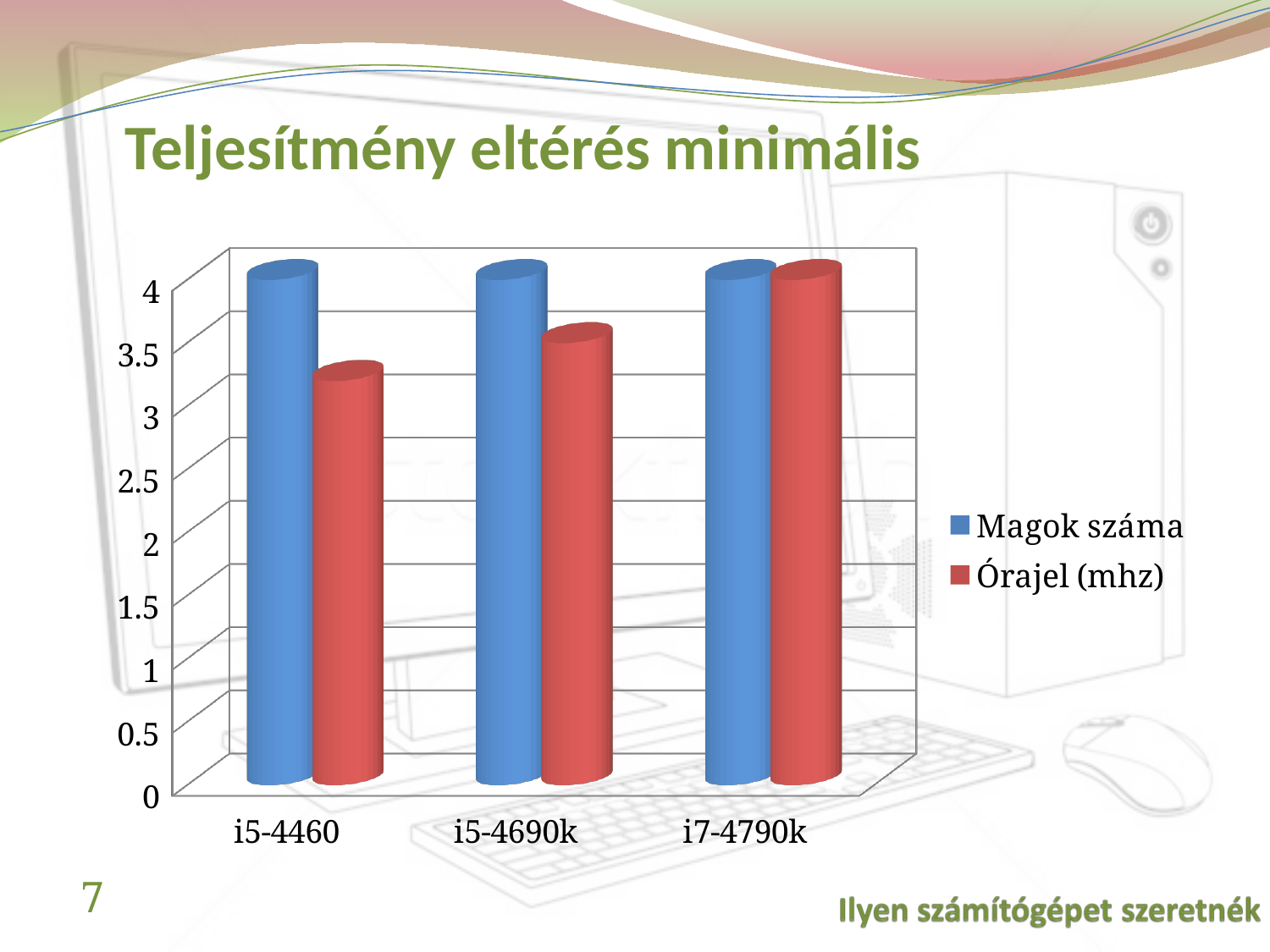
Is the Órajel (mhz) value for i5-4460 greater or less than 3.5? less Which processor has the lowest Órajel (mhz) value? i5-4460 What are the two series named in the chart's legend? Magok száma and Órajel (mhz) What is the title of the slide containing the chart? Teljesítmény eltérés minimális Is the Magok száma value for i5-4460 greater or less than 3.5? greater Do the Órajel (mhz) values rise or fall from i5-4460 to i7-4790k along the x axis? rise For i5-4460, which is larger: Magok száma or Órajel (mhz)? Magok száma Is the Órajel (mhz) value for i5-4460 greater or less than 3? greater How many processor categories are shown on the x axis of the chart? 3 How many series does the chart's legend list? 2 What kind of chart is shown on the slide? bar chart Which processor has the highest Órajel (mhz) value? i7-4790k